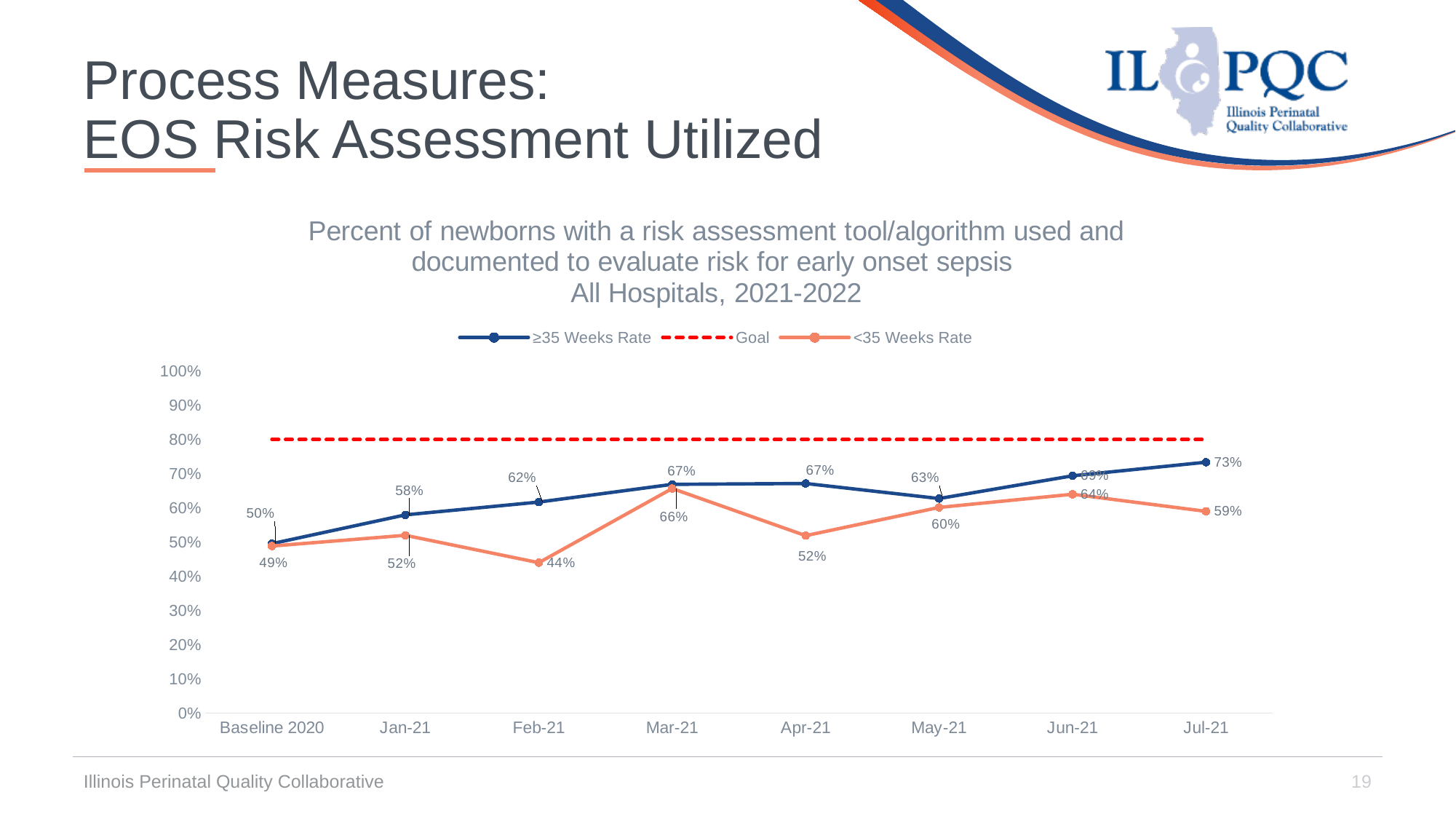
How many time points are plotted on the x axis? 8 In which month is the ≥35 Weeks Rate highest? Jul-21 In which month is the <35 Weeks Rate lowest? Feb-21 How many series does the legend list? 3 What kind of chart is shown on the slide? Line chart What is the difference between the ≥35 Weeks Rate and the <35 Weeks Rate in Mar-21? 1 percentage point What is the difference between the ≥35 Weeks Rate and the <35 Weeks Rate in Jul-21? 14 percentage points What is the <35 Weeks Rate for May-21? 60% What is the ≥35 Weeks Rate for Jul-21? 73% In Apr-21, which is larger: the ≥35 Weeks Rate or the <35 Weeks Rate? ≥35 Weeks Rate At what percentage does the Goal line sit? 80% What is the <35 Weeks Rate for Feb-21? 44%